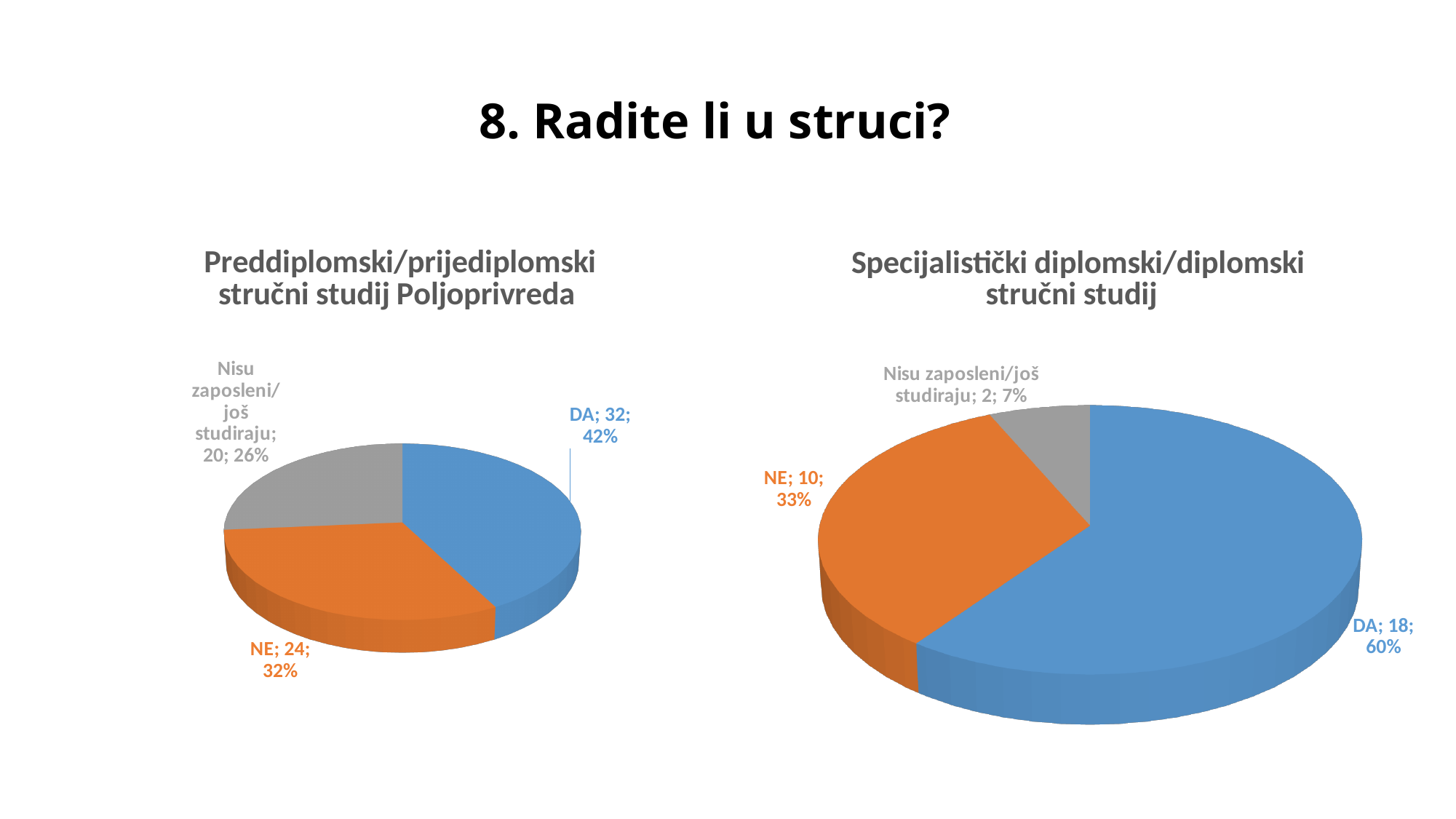
In the right chart (Specijalistički diplomski/diplomski stručni studij), what is the value for NE? 10 In the left chart (Preddiplomski/prijediplomski stručni studij Poljoprivreda), which category has the smallest slice? Nisu zaposleni/još studiraju In the right chart (Specijalistički diplomski/diplomski stručni studij), what is the total of all slices? 30 In the left chart (Preddiplomski/prijediplomski stručni studij Poljoprivreda), what is the value for DA? 32 In the right chart (Specijalistički diplomski/diplomski stručni studij), what is the value for Nisu zaposleni/još studiraju? 2 In the right chart (Specijalistički diplomski/diplomski stručni studij), what percentage share does DA have? 60% In the left chart (Preddiplomski/prijediplomski stručni studij Poljoprivreda), what percentage share does NE have? 32% In the left chart (Preddiplomski/prijediplomski stručni studij Poljoprivreda), how many slices does the pie have? 3 What type of chart is used on this slide? Pie chart Which is larger: the DA value in the left chart or the DA value in the right chart? Left chart (32) In the right chart (Specijalistički diplomski/diplomski stručni studij), which category has the largest slice? DA In the left chart (Preddiplomski/prijediplomski stručni studij Poljoprivreda), what is the difference between the DA and NE values? 8